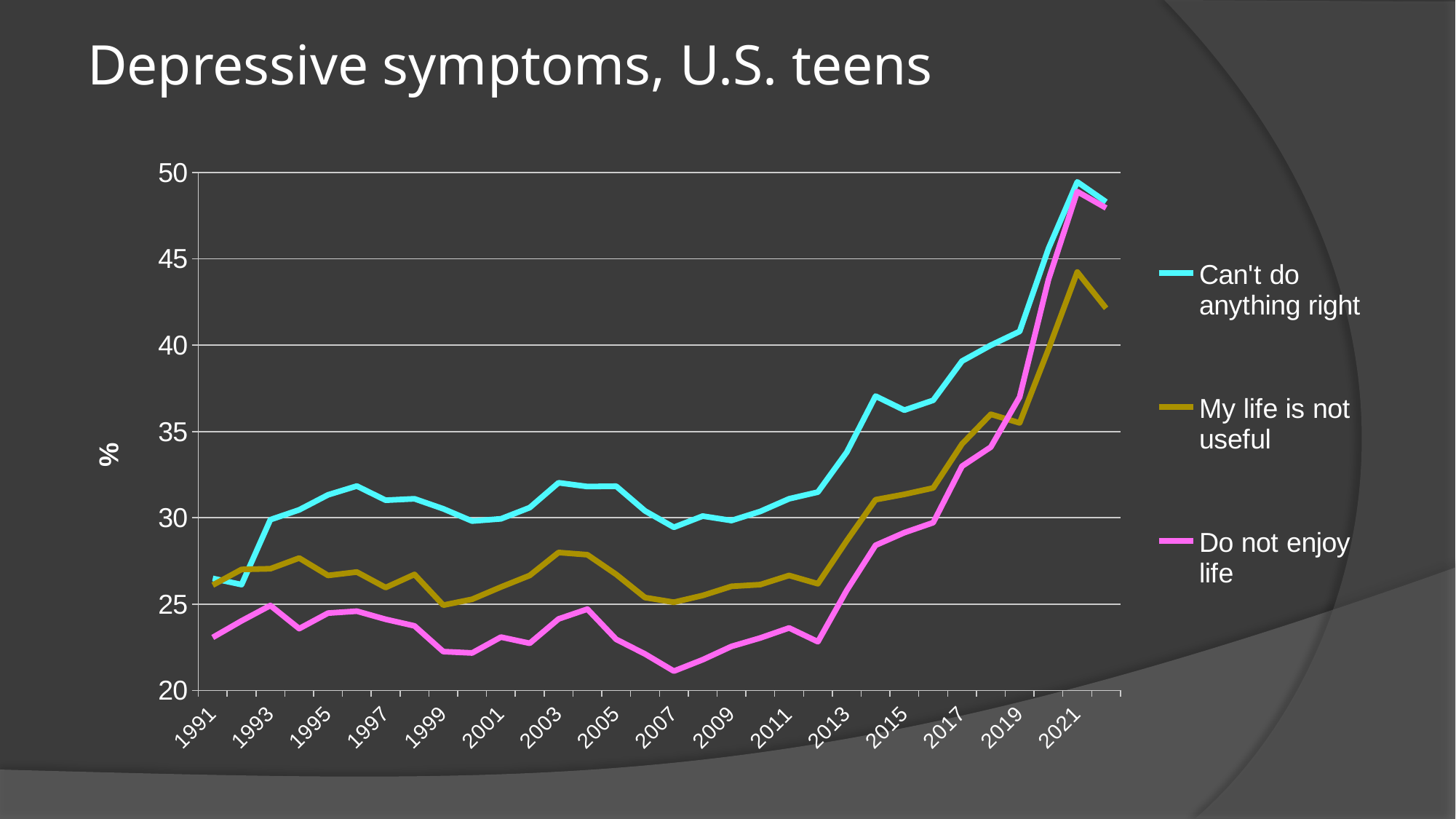
Is the value for "Do not enjoy life" in 1991 greater or less than 25? less How many series does the legend list? 3 Is the value for "Can't do anything right" in 2021 greater or less than 45? greater Which series has the lowest value in 2021? My life is not useful Is the value for "My life is not useful" in 2021 greater or less than 40? greater Do the values for "Can't do anything right" rise or fall between 2013 and 2021? rise Which series has the lowest value in 2007? Do not enjoy life What is the title of the chart? Depressive symptoms, U.S. teens What is the label on the vertical axis? % What kind of chart is shown on the slide? line chart In 2013, which is larger: the value for "Can't do anything right" or the value for "Do not enjoy life"? Can't do anything right